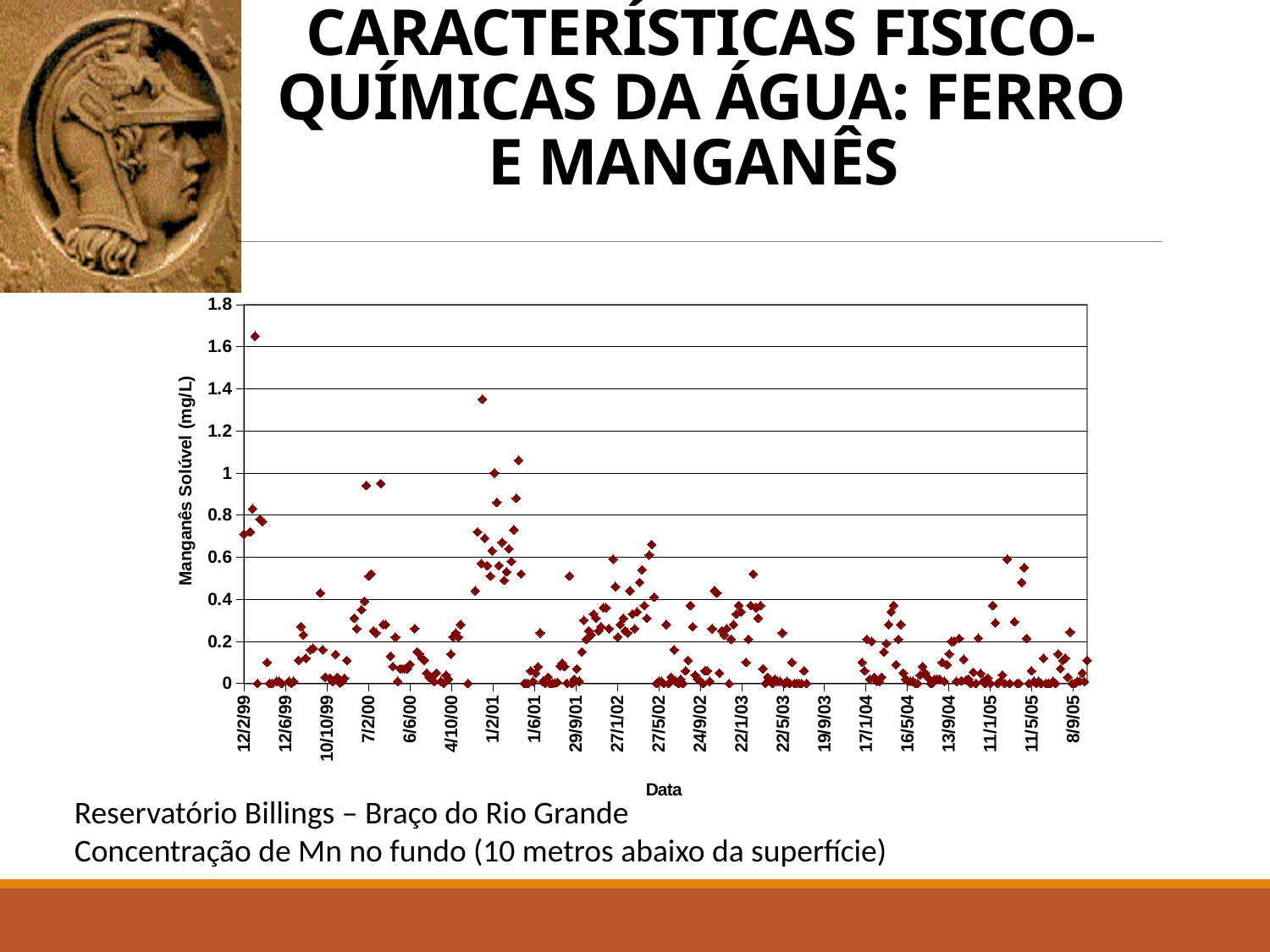
Is the highest value plotted near 7/2/00 greater or less than 0.8? greater Do the peak values of the plotted points generally rise or fall from 1999 to 2005? fall What is the maximum value shown on the vertical axis of the chart? 1.8 Is the highest value plotted near 1/2/01 greater or less than 1.2? greater Is the highest plotted value on the chart greater or less than 1.6? greater Near which x-axis date does the highest point on the chart occur? 12/2/99 What is the label of the horizontal axis of the chart? Data What kind of chart is shown on the slide? scatter plot What is the label of the vertical axis of the chart? Manganês Solúvel (mg/L)